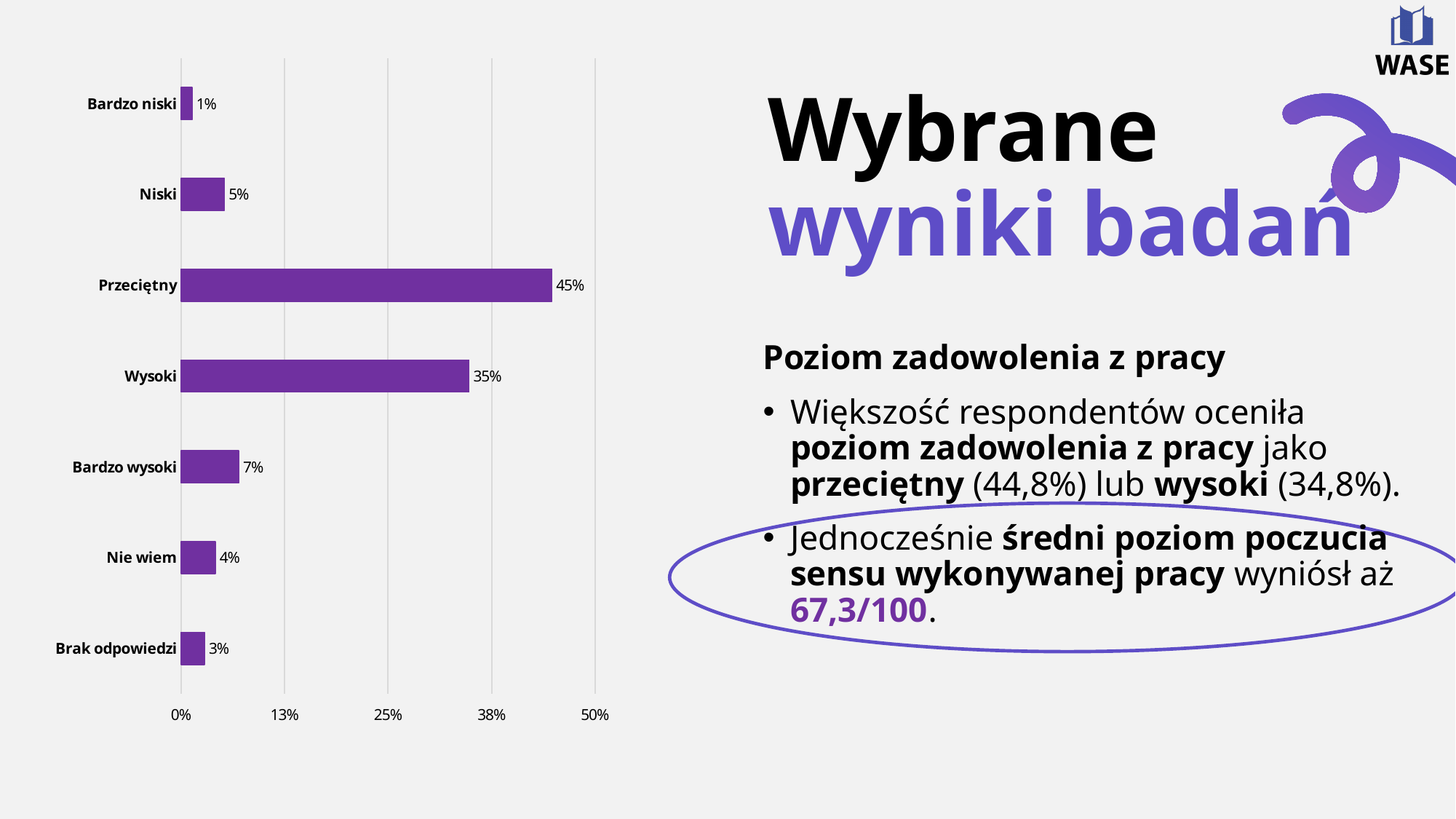
What is the value for Wysoki? 35% What is the value for Przeciętny? 45% What is the difference between the values for Nie wiem and Brak odpowiedzi? 1% How many categories are shown in the chart? 7 Which category has the lowest value? Bardzo niski What kind of chart is shown on the slide? bar chart Is the value for Wysoki greater or less than 25%? greater What is the value for Bardzo niski? 1% Which is larger, the value for Bardzo wysoki or the value for Niski? Bardzo wysoki Which category has the highest value? Przeciętny What is the value for Brak odpowiedzi? 3% What is the difference between the values for Przeciętny and Wysoki? 10%